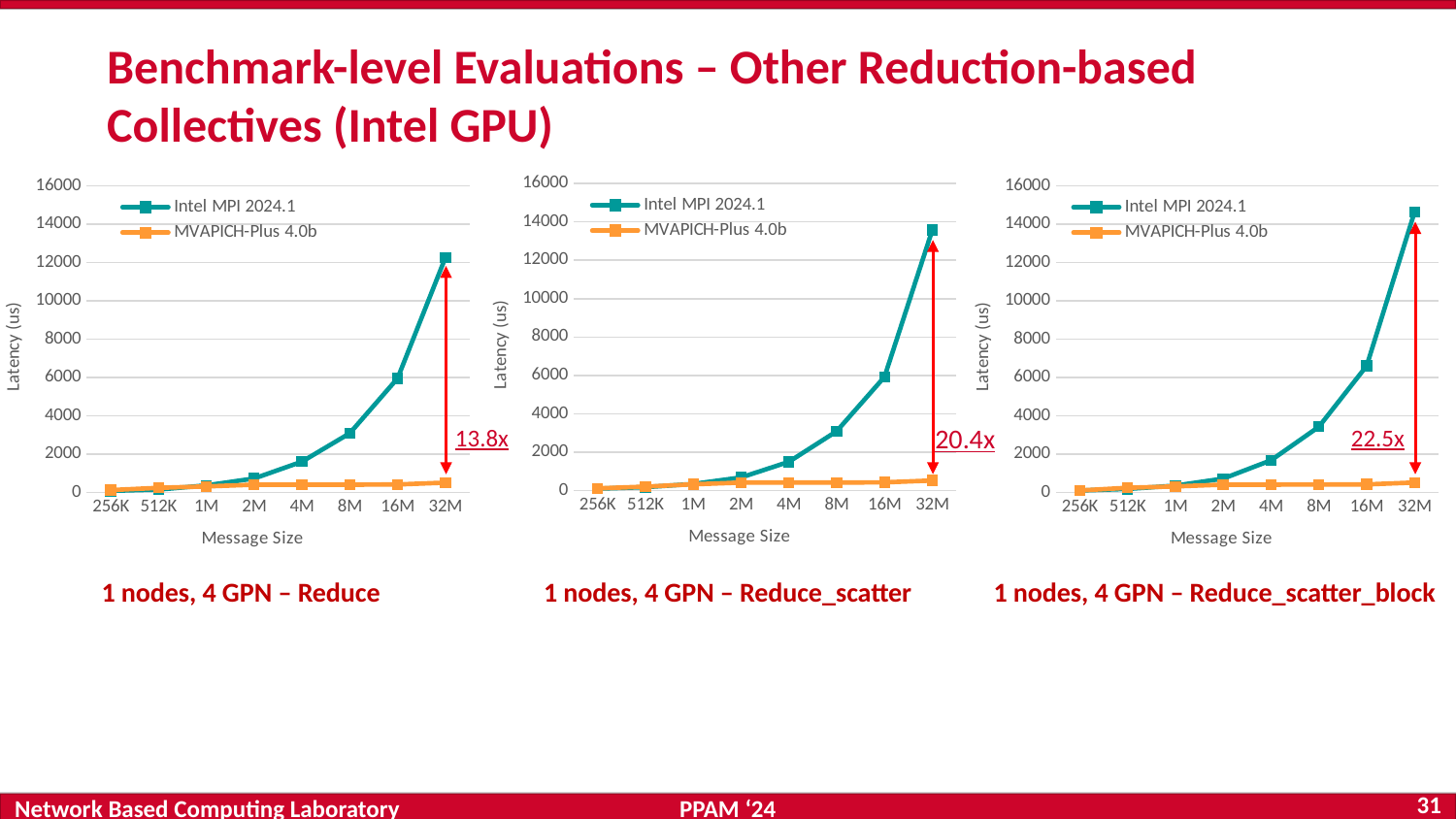
In the '1 nodes, 4 GPN – Reduce_scatter' chart, does the Intel MPI 2024.1 latency rise or fall as message size increases? rise In the '1 nodes, 4 GPN – Reduce' chart, at which message size does Intel MPI 2024.1 reach its highest latency? 32M In the '1 nodes, 4 GPN – Reduce_scatter' chart, is the Intel MPI 2024.1 latency at 32M greater or less than 12000? greater What kind of chart is the '1 nodes, 4 GPN – Reduce' chart? line chart In the '1 nodes, 4 GPN – Reduce' chart, is the Intel MPI 2024.1 latency at 32M greater or less than 10000? greater In the '1 nodes, 4 GPN – Reduce_scatter_block' chart, is the MVAPICH-Plus 4.0b latency at 32M greater or less than 2000? less In the '1 nodes, 4 GPN – Reduce' chart, how many message sizes are shown on the x axis? 8 How many series does the legend of the '1 nodes, 4 GPN – Reduce_scatter' chart list? 2 What speedup factor is annotated on the '1 nodes, 4 GPN – Reduce_scatter_block' chart? 22.5x What speedup factor is annotated on the '1 nodes, 4 GPN – Reduce' chart? 13.8x In the '1 nodes, 4 GPN – Reduce_scatter_block' chart, which series has the higher latency at 32M, Intel MPI 2024.1 or MVAPICH-Plus 4.0b? Intel MPI 2024.1